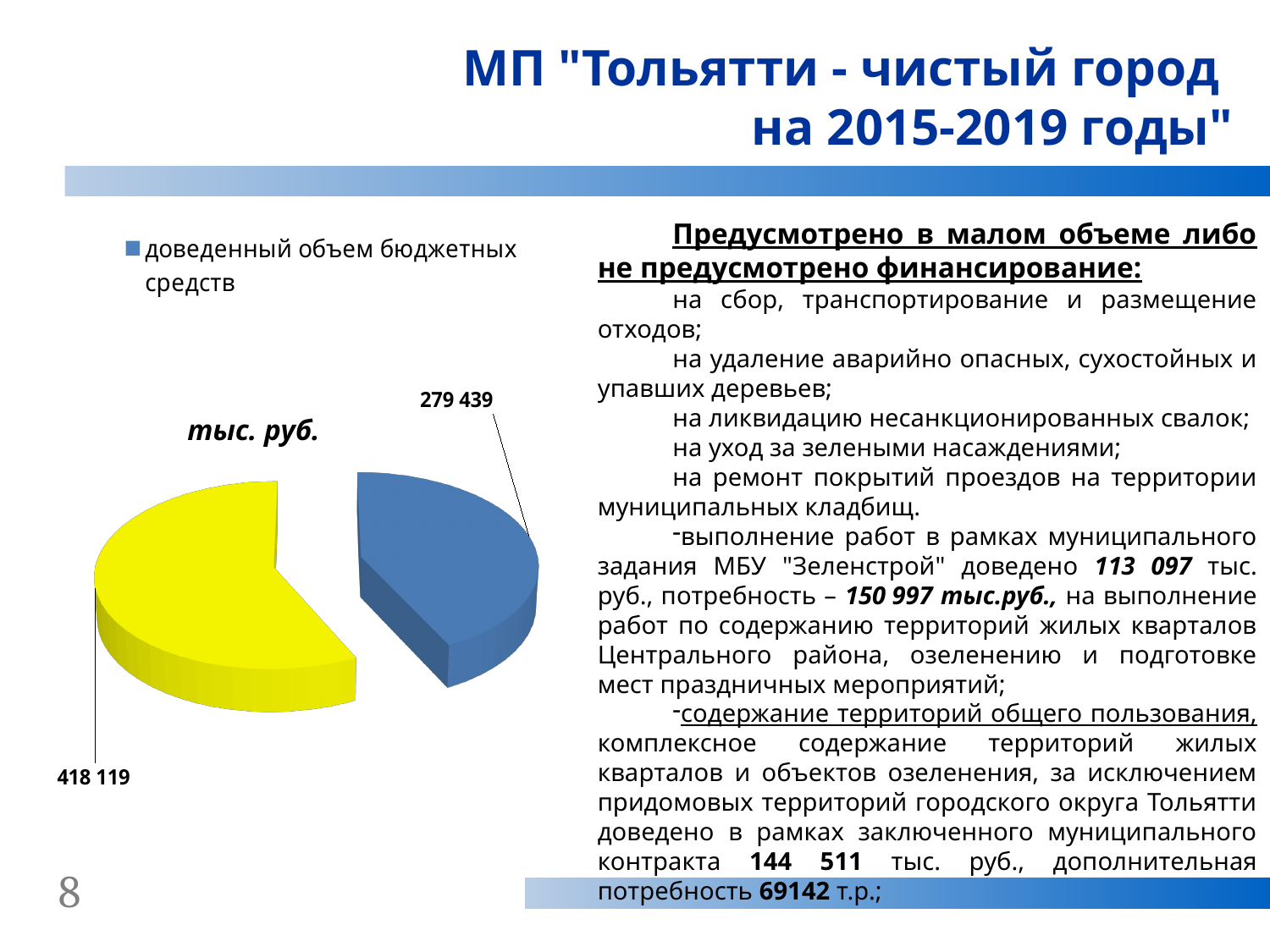
Which slice of the pie chart has the larger value, the blue or the yellow one? yellow What is the difference between the yellow slice value and the blue slice value in the pie chart? 138 680 How many entries does the legend of the pie chart list? 1 What unit label is shown next to the pie chart? тыс. руб. Which slice of the pie chart has the smaller value? blue (доведенный объем бюджетных средств) What kind of chart is shown on the slide? pie chart What is the value of the blue slice (доведенный объем бюджетных средств) in the pie chart? 279 439 Is the value of the blue slice (279 439) larger or smaller than the value of the yellow slice (418 119)? smaller How many slices does the pie chart have? 2 What is the total of the two slice values shown in the pie chart? 697 558 What is the legend entry shown for the pie chart? доведенный объем бюджетных средств What is the value of the yellow slice in the pie chart? 418 119